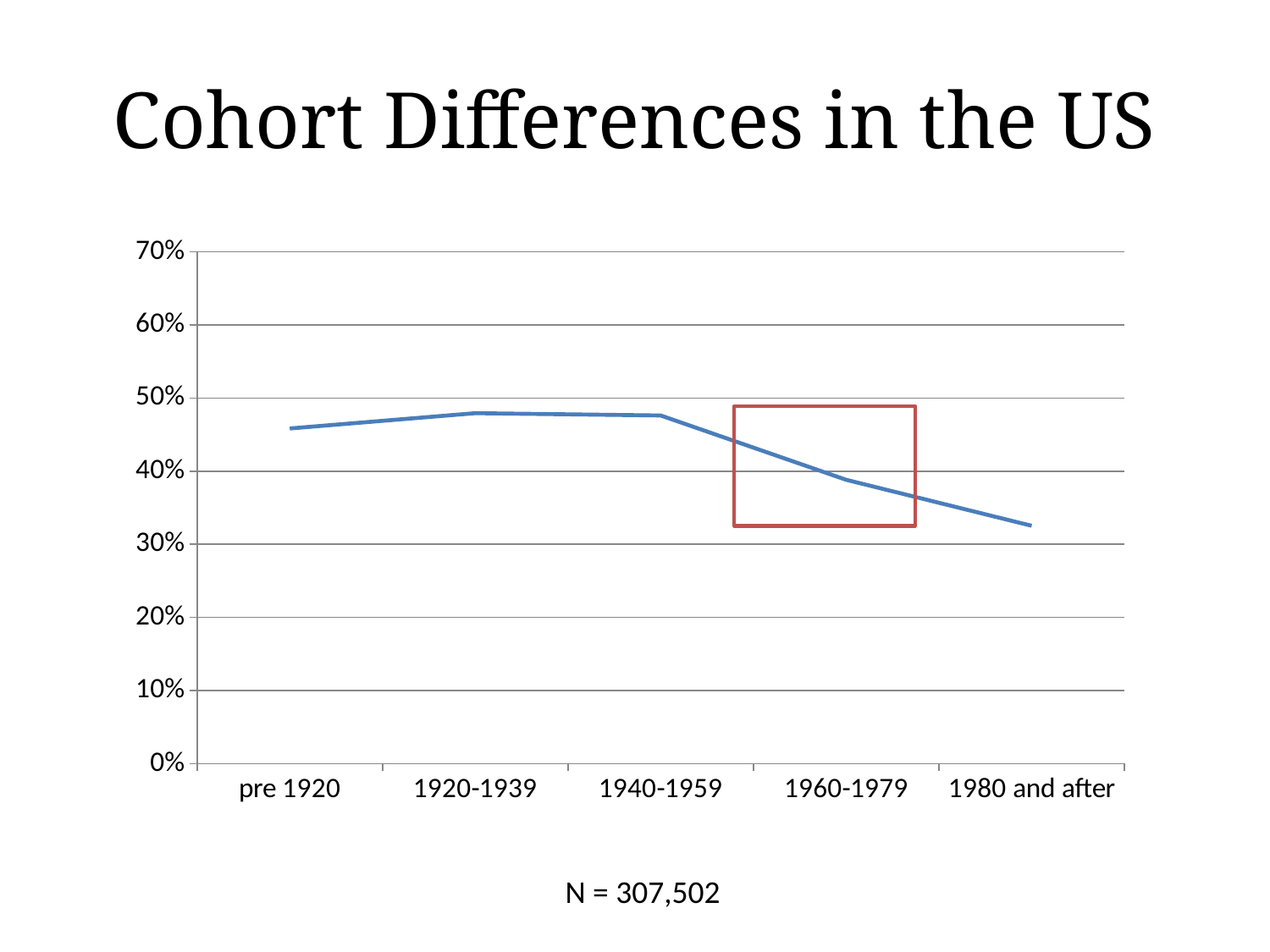
Which cohort has the lowest value? 1980 and after Do the values rise or fall from 1940-1959 to 1980 and after? fall Is the value for 1960-1979 greater or less than 40%? less What kind of chart is shown on the slide? line chart What is the title of the slide? Cohort Differences in the US Is the value for pre 1920 greater or less than 50%? less Is the value for 1920-1939 greater or less than 50%? less What sample size (N) is stated below the chart? N = 307,502 How many cohort categories are plotted along the x axis? 5 Which is larger, the value for 1940-1959 or the value for 1960-1979? 1940-1959